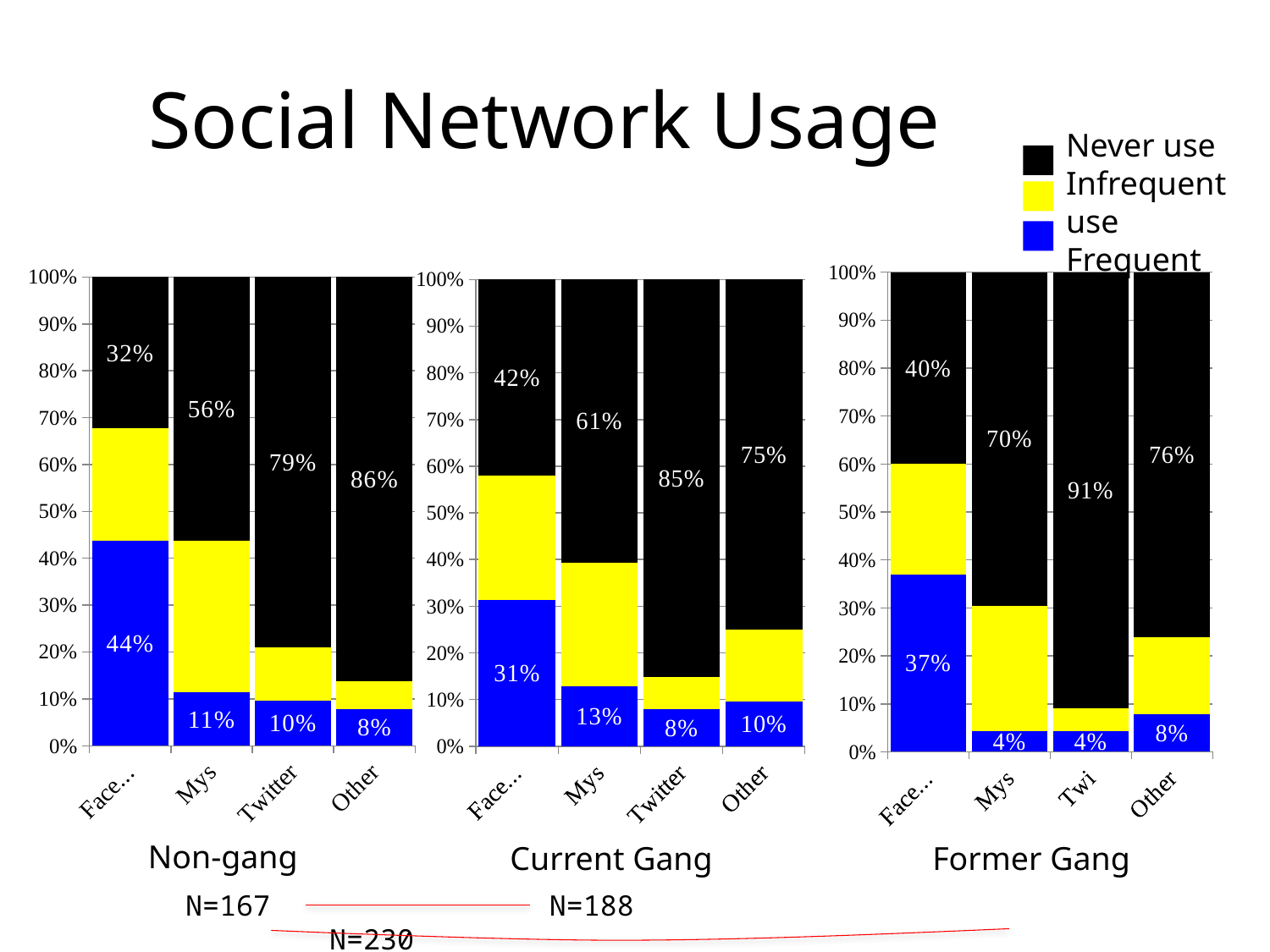
In the Current Gang chart, which has the larger Never use percentage, Twitter or Other? Twitter In the Current Gang chart, what is the Frequent use percentage for Twitter? 8% In the Non-gang chart, what is the Never use percentage for Other? 86% In the Former Gang chart, is the Infrequent use value for Mys greater or less than 20%? greater How many categories are shown on the x axis of the Non-gang chart? 4 In the Current Gang chart, what is the Never use percentage for Mys? 61% In the Non-gang chart, what is the difference between the Never use percentages for Other and Twitter? 7 percentage points In the Former Gang chart, what is the Never use percentage for Twi? 91% What kind of chart is the Current Gang chart? Stacked bar chart How many series does the legend list? 3 In the Former Gang chart, which category has the highest Never use percentage? Twi In the Non-gang chart, which category has the highest Never use percentage? Other